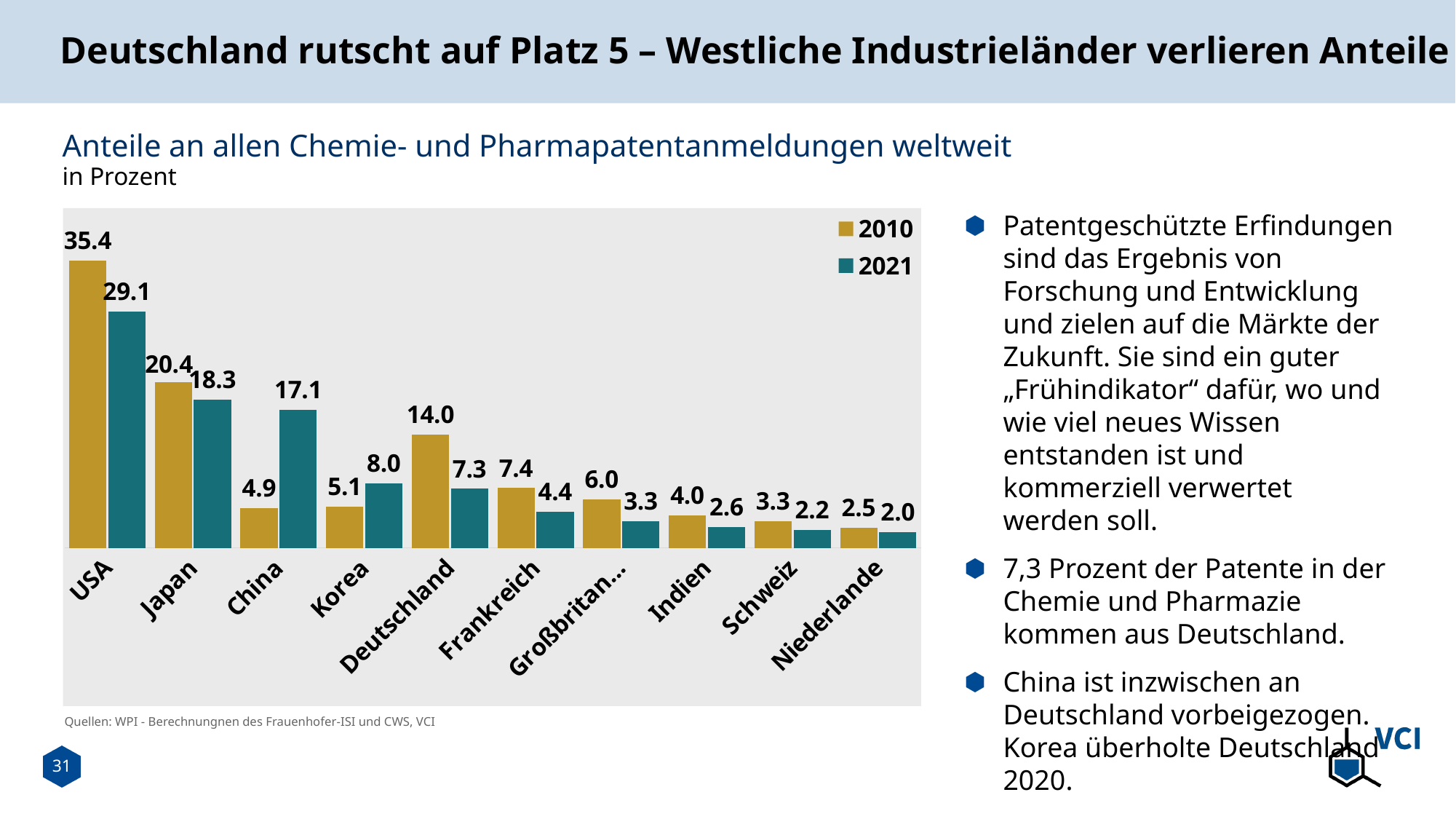
Which country had the lowest share in 2010? Niederlande What was Deutschland's share in 2021? 7.3 How many series does the legend list? 2 What was the USA's share of chemical and pharmaceutical patent applications in 2021? 29.1 What was China's share in 2010? 4.9 Which years are listed in the chart legend? 2010 and 2021 How many countries are shown on the x axis? 10 What is the difference between Korea's 2021 share and its 2010 share? 2.9 Which was larger in 2021: China's share or Japan's share? Japan By how much did Deutschland's share fall from 2010 to 2021? 6.7 What kind of chart is shown on the slide? Bar chart Which country had the highest share in 2021? USA